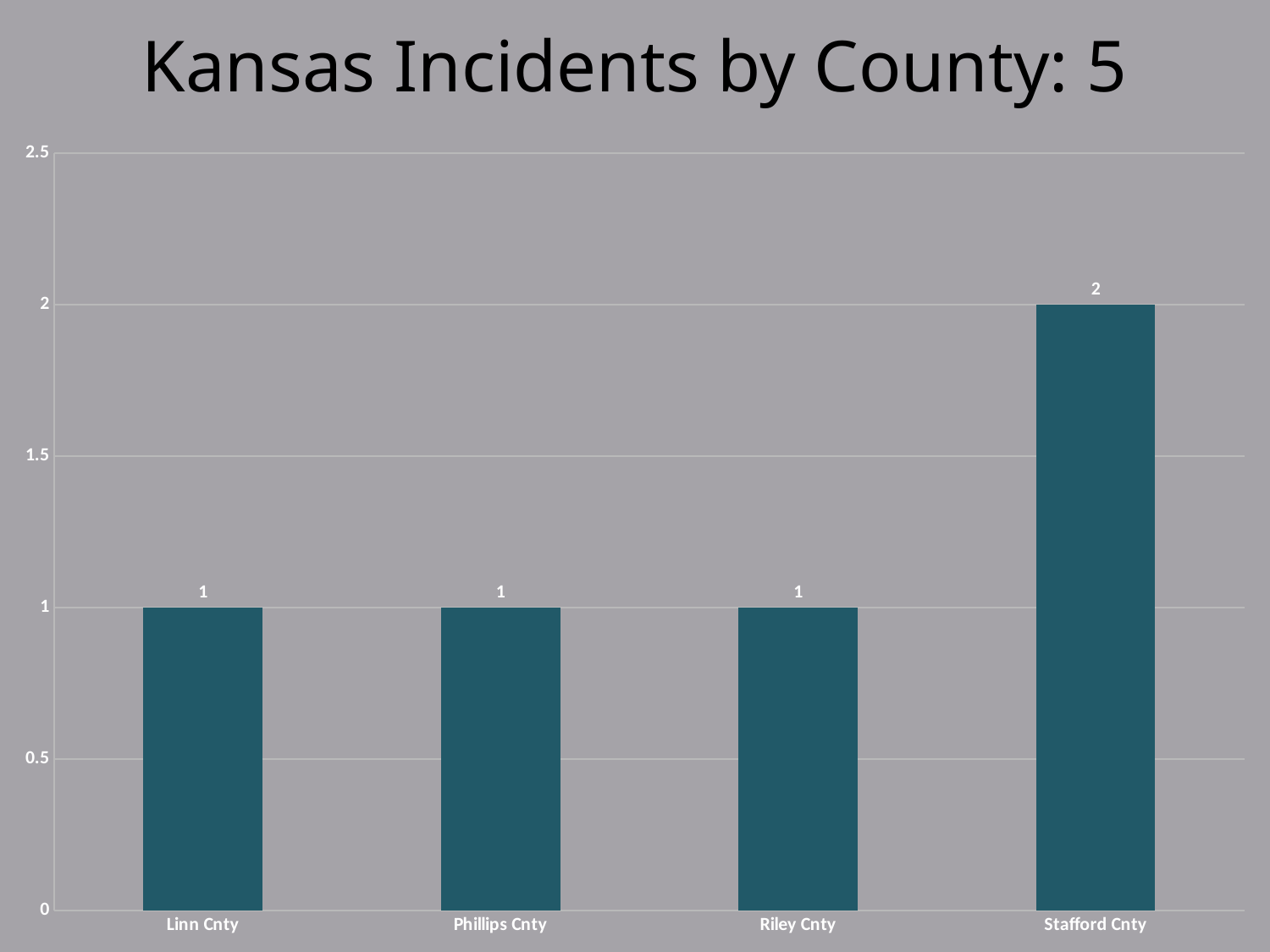
What is the difference between the values for Stafford Cnty and Phillips Cnty? 1 Which county has the highest value? Stafford Cnty Is the value for Phillips Cnty greater or less than 1.5? less What is the value for Riley Cnty? 1 What kind of chart is shown on the slide? bar chart Is the value for Stafford Cnty greater or less than 1.5? greater Which is larger, the value for Stafford Cnty or the value for Riley Cnty? Stafford Cnty What is the title of the slide? Kansas Incidents by County: 5 How many counties are shown on the chart? 4 What is the value for Linn Cnty? 1 What is the highest value shown on the vertical axis? 2.5 What is the value for Stafford Cnty? 2